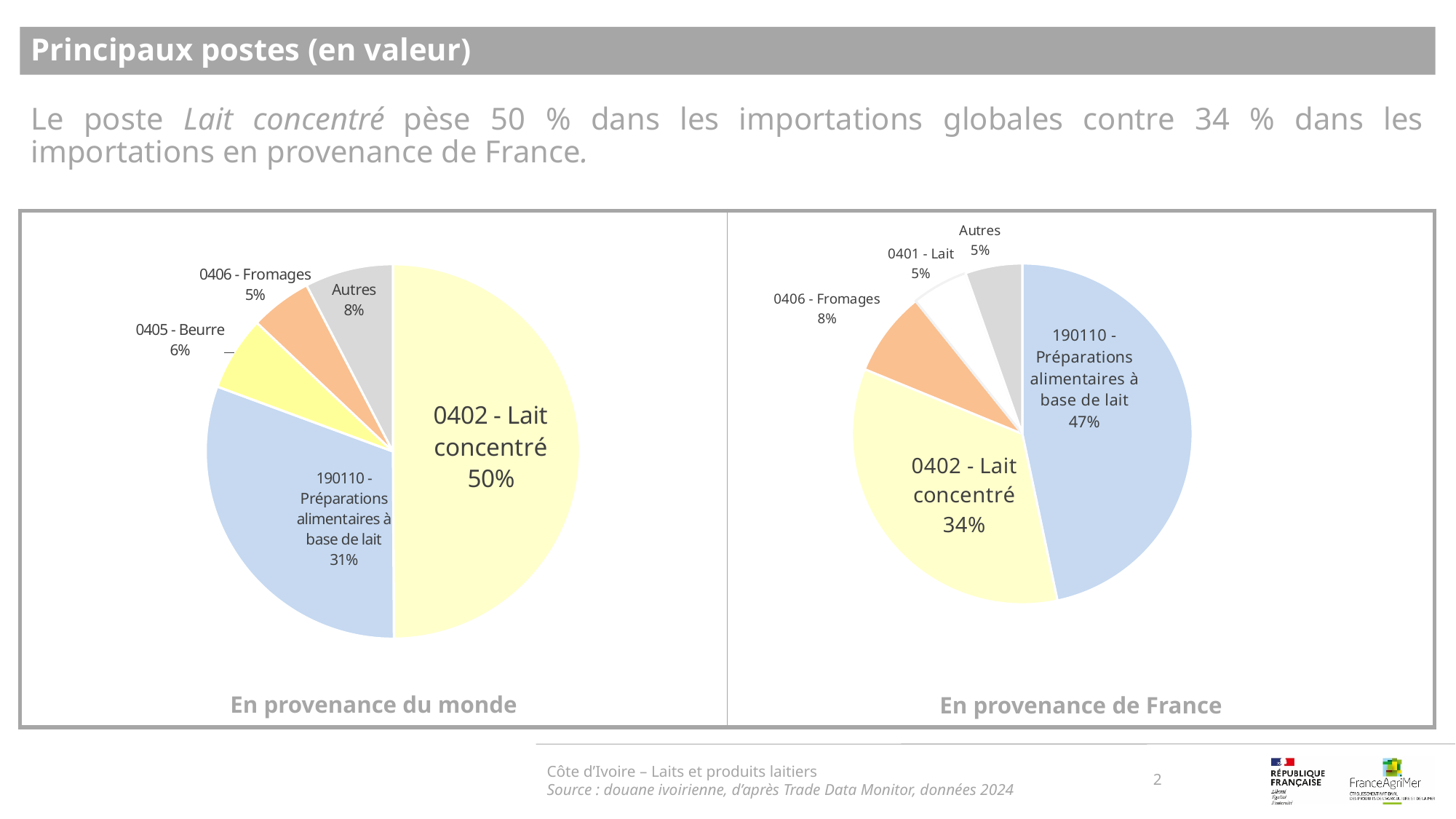
In the 'En provenance de France' chart, which is larger: '0406 - Fromages' or 'Autres'? 0406 - Fromages In the 'En provenance de France' chart, what is the value for '0406 - Fromages'? 8% In the 'En provenance du monde' chart, which category has the smallest slice? 0406 - Fromages In the 'En provenance du monde' chart, which category has the largest slice? 0402 - Lait concentré In the 'En provenance du monde' chart, what share does '0402 - Lait concentré' have? 50% What type of chart is the 'En provenance du monde' chart? Pie chart In the 'En provenance de France' chart, what share does '190110 - Préparations alimentaires à base de lait' have? 47% In the 'En provenance du monde' chart, what is the value for '0405 - Beurre'? 6% In the 'En provenance du monde' chart, what is the difference between '0402 - Lait concentré' and '190110 - Préparations alimentaires à base de lait'? 19% In the 'En provenance de France' chart, what is the difference between '190110 - Préparations alimentaires à base de lait' and '0402 - Lait concentré'? 13% How many slices does the 'En provenance de France' chart have? 5 In the 'En provenance de France' chart, which category has the largest slice? 190110 - Préparations alimentaires à base de lait